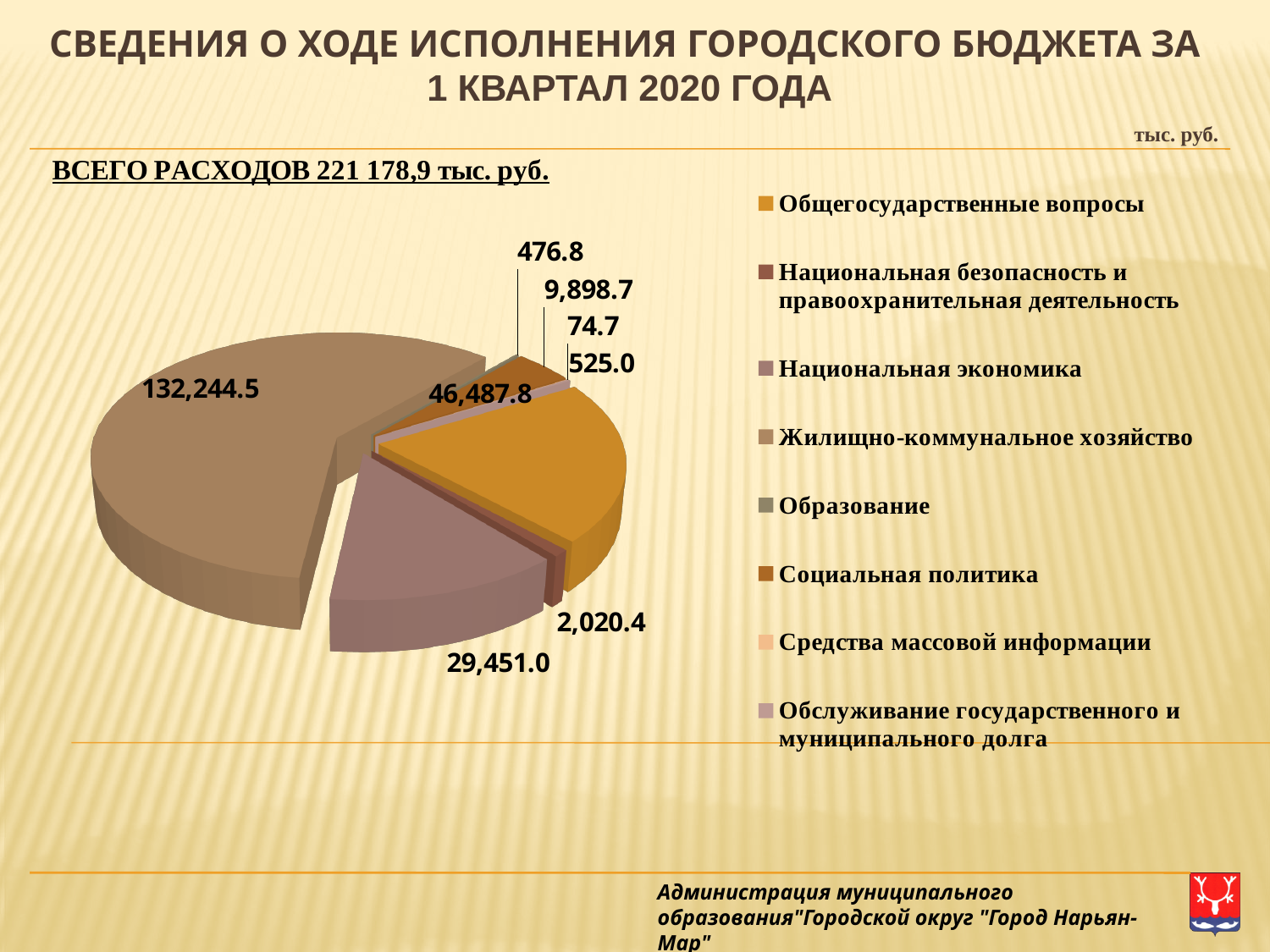
What total expenditure is stated above the pie chart? 221 178,9 тыс. руб. Which is larger, the value for Национальная экономика or the value for Общегосударственные вопросы? Общегосударственные вопросы What kind of chart is shown on the slide? pie chart What is the value for Общегосударственные вопросы? 46,487.8 What is the value for Национальная безопасность и правоохранительная деятельность? 2,020.4 What is the value for Национальная экономика? 29,451.0 Which category has the largest slice of the pie? Жилищно-коммунальное хозяйство What is the value for Жилищно-коммунальное хозяйство? 132,244.5 What is the difference between the values for Жилищно-коммунальное хозяйство and Общегосударственные вопросы? 85,756.7 What is the smallest value labelled on the pie chart? 74.7 How many categories does the legend of the pie chart list? 8 What is the difference between the values for Общегосударственные вопросы and Национальная экономика? 17,036.8